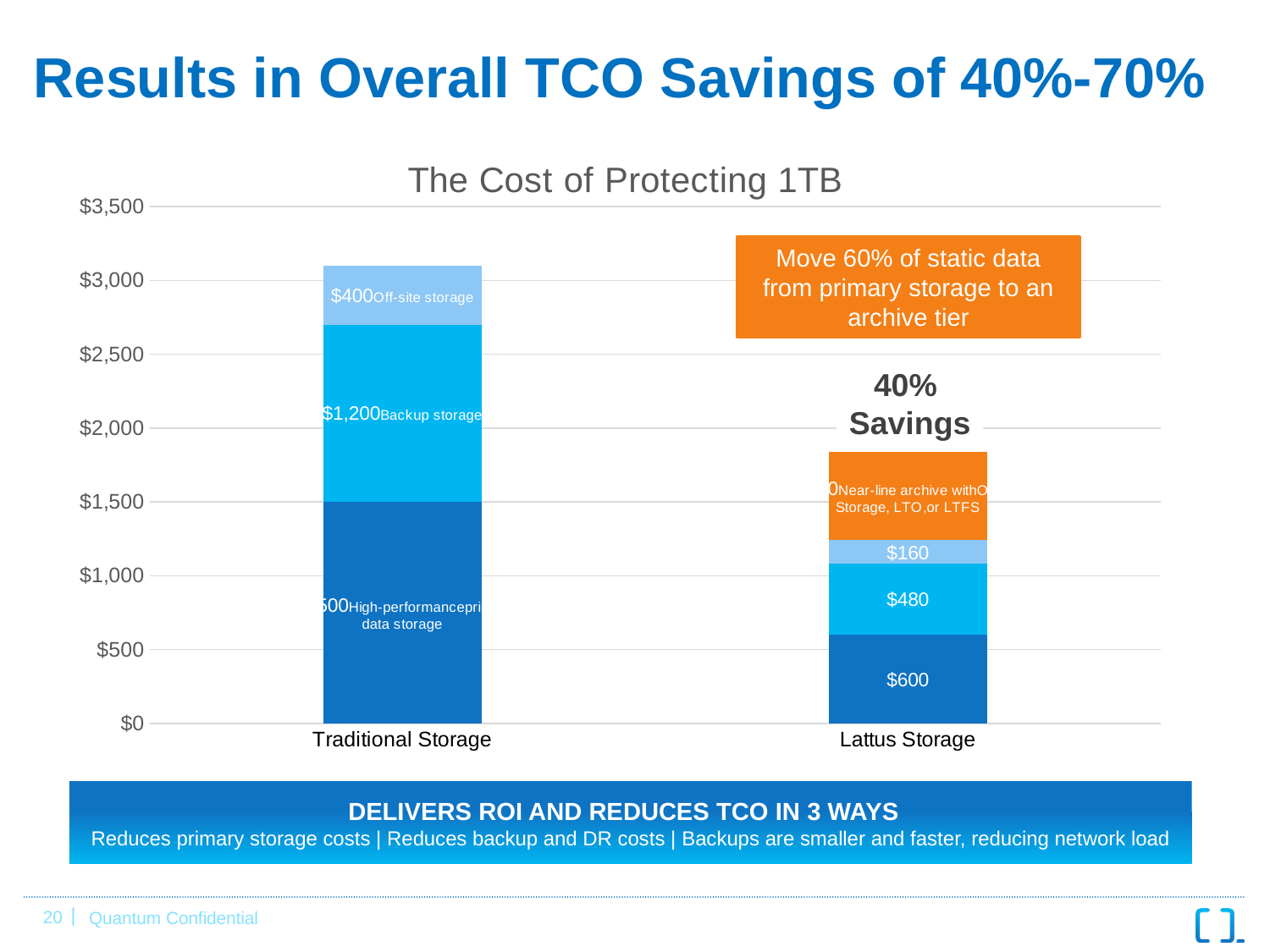
What is the value of the bottom (dark blue) segment of the Lattus Storage bar? $600 What is the value of the pale blue segment in the Lattus Storage bar? $160 What is the difference between the $600 and $480 segments in the Lattus Storage bar? $120 What is the title of the chart? The Cost of Protecting 1TB What kind of chart is shown on the slide? Stacked bar chart What is the cost of off-site storage in the Traditional Storage bar? $400 Is the total height of the Lattus Storage bar greater or less than $2,000? less Which storage option has the higher total cost bar, Traditional Storage or Lattus Storage? Traditional Storage How much more does backup storage cost than off-site storage in the Traditional Storage bar? $800 How many storage categories are shown on the x axis of the chart? 2 What is the value of the light blue segment directly above the $600 segment in the Lattus Storage bar? $480 What is the cost of backup storage in the Traditional Storage bar? $1,200